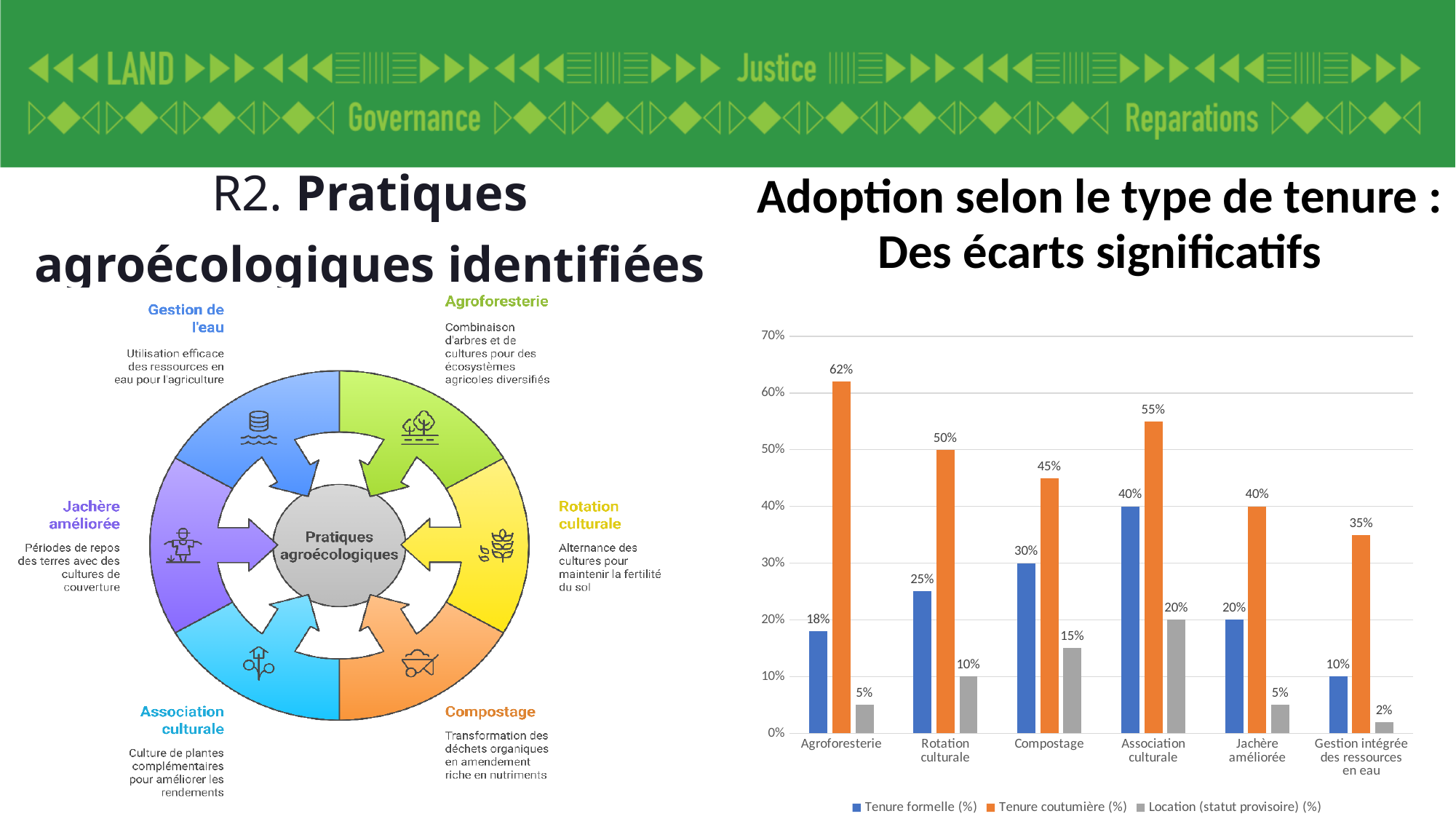
In the chart 'Adoption selon le type de tenure', what is the value for Tenure formelle (%) for Compostage? 30% In the chart 'Adoption selon le type de tenure', which category has the highest value for Tenure formelle (%)? Association culturale How many categories are shown on the x axis of the chart 'Adoption selon le type de tenure'? 6 How many series does the legend of the chart 'Adoption selon le type de tenure' list? 3 In the chart 'Adoption selon le type de tenure', which is larger for Rotation culturale: Tenure formelle (%) or Location (statut provisoire) (%)? Tenure formelle (%) In the chart 'Adoption selon le type de tenure', what is the value for Tenure coutumière (%) for Agroforesterie? 62% In the chart 'Adoption selon le type de tenure', is the value for Tenure coutumière (%) for Association culturale greater or less than 50%? greater In the chart 'Adoption selon le type de tenure', what is the value for Location (statut provisoire) (%) for Gestion intégrée des ressources en eau? 2% In the chart 'Adoption selon le type de tenure', what colour are the bars for Tenure coutumière (%)? orange In the chart 'Adoption selon le type de tenure', what is the difference between Tenure coutumière (%) and Tenure formelle (%) for Agroforesterie? 44% What type of chart is shown on the right side of the slide? bar chart In the chart 'Adoption selon le type de tenure', which category has the lowest value for Tenure coutumière (%)? Gestion intégrée des ressources en eau